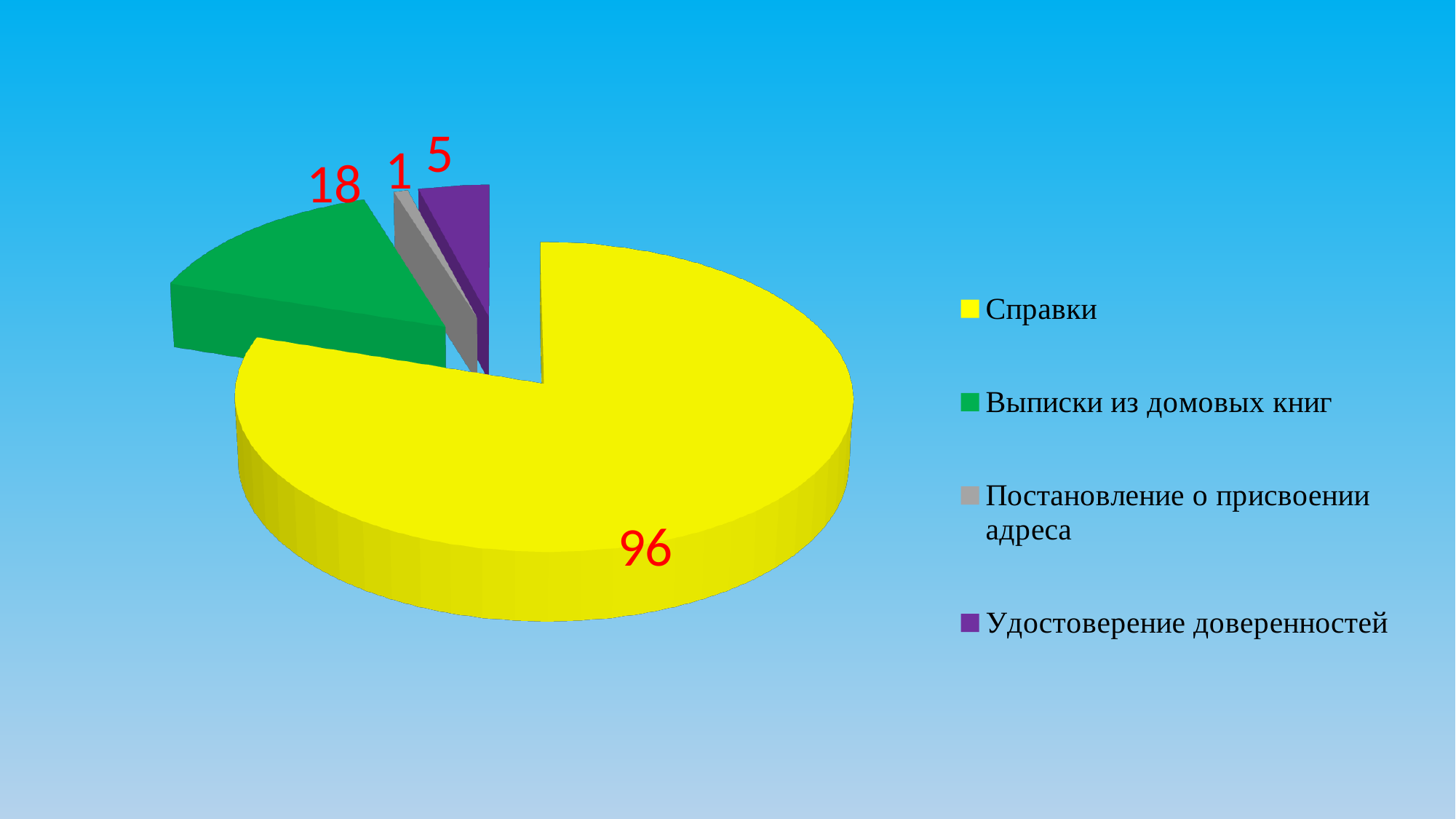
What kind of chart is shown on the slide? Pie chart Which category has the smallest slice? Постановление о присвоении адреса What is the value for Справки? 96 Which is larger, the value for Удостоверение доверенностей or the value for Постановление о присвоении адреса? Удостоверение доверенностей What is the value for Удостоверение доверенностей? 5 What is the difference between the values for Справки and Выписки из домовых книг? 78 What is the value for Выписки из домовых книг? 18 How many categories does the pie chart have? 4 What colour is the slice for Выписки из домовых книг? Green What is the value for Постановление о присвоении адреса? 1 Which category has the largest slice? Справки What share of the pie does Справки represent? 80%